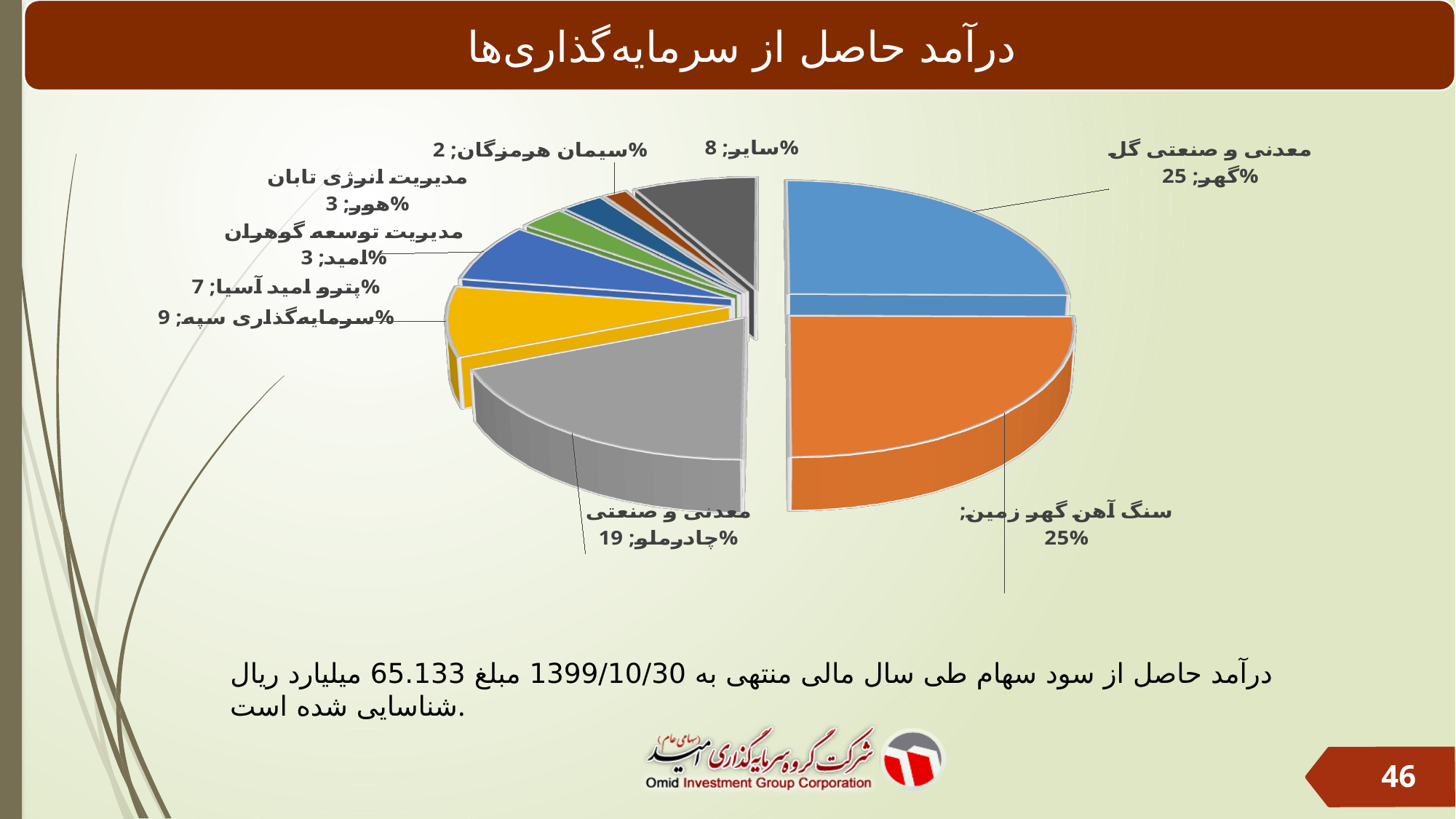
Which is larger, the share of سرمایه‌گذاری سپه or the share of پترو امید آسیا? سرمایه‌گذاری سپه What is the value shown for سنگ آهن گهر زمین? 25% What is the value shown for سرمایه‌گذاری سپه? 9% What is the value shown for پترو امید آسیا? 7% What is the title of the chart? درآمد حاصل از سرمایه‌گذاری‌ها What kind of chart is shown on the slide? pie chart What is the value shown for مدیریت انرژی تابان هور? 3% What share of the pie does معدنی و صنعتی چادرملو hold? 19% What is the value shown for سایر? 8% What is the difference between the shares of معدنی و صنعتی گل گهر and معدنی و صنعتی چادرملو? 6% Which category has the smallest slice of the pie? سیمان هرمزگان How many slices does the pie chart have? 9